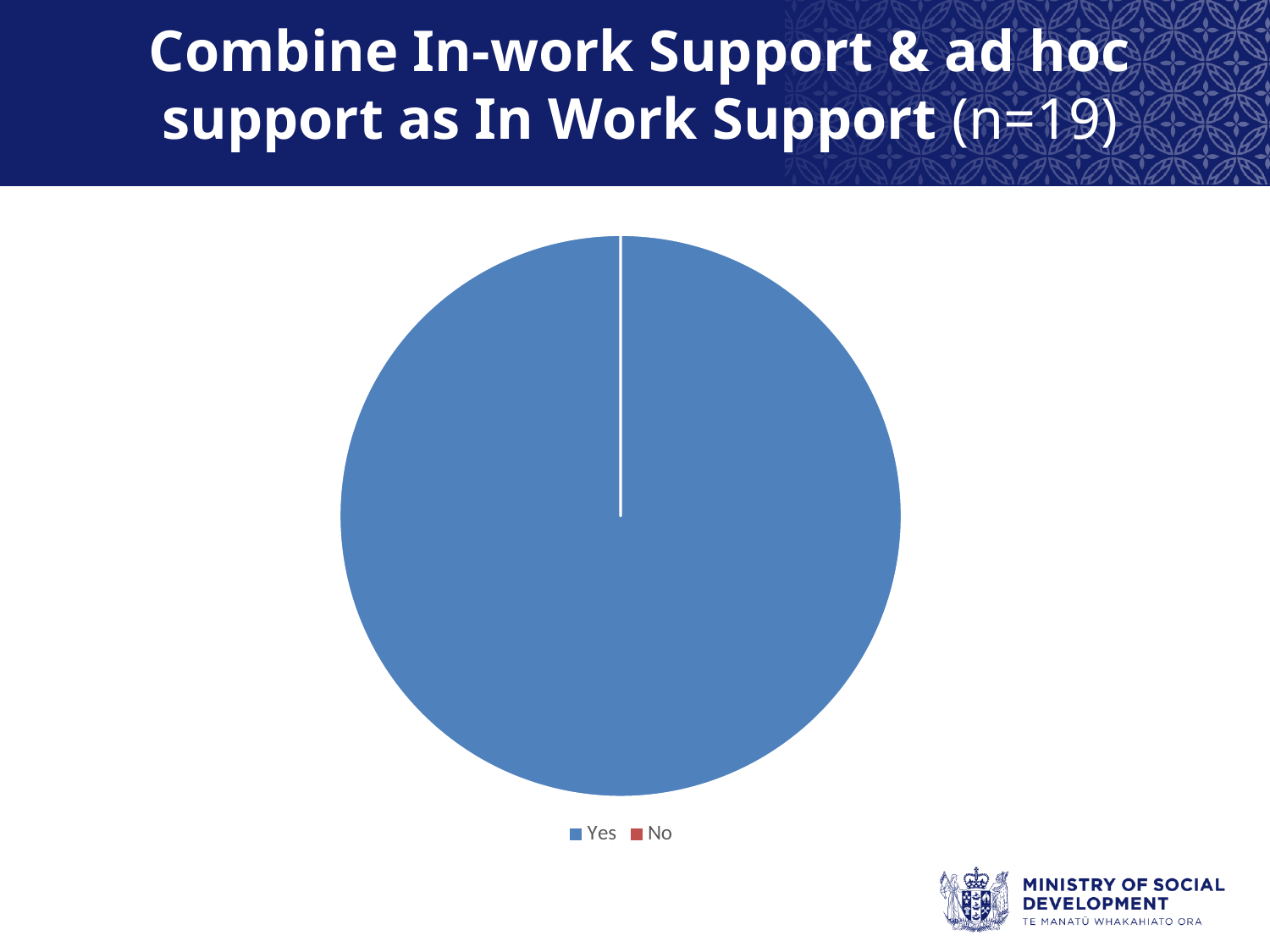
What sample size (n) is stated in the slide title? 19 Which slice is larger in the pie chart, Yes or No? Yes Which category has the largest slice of the pie chart? Yes How many categories does the legend of the pie chart list? 2 Which category has the smallest slice of the pie chart? No What kind of chart is shown on the slide? pie chart What colour represents the Yes category in the pie chart legend? blue What is the title of the slide containing the pie chart? Combine In-work Support & ad hoc support as In Work Support (n=19)